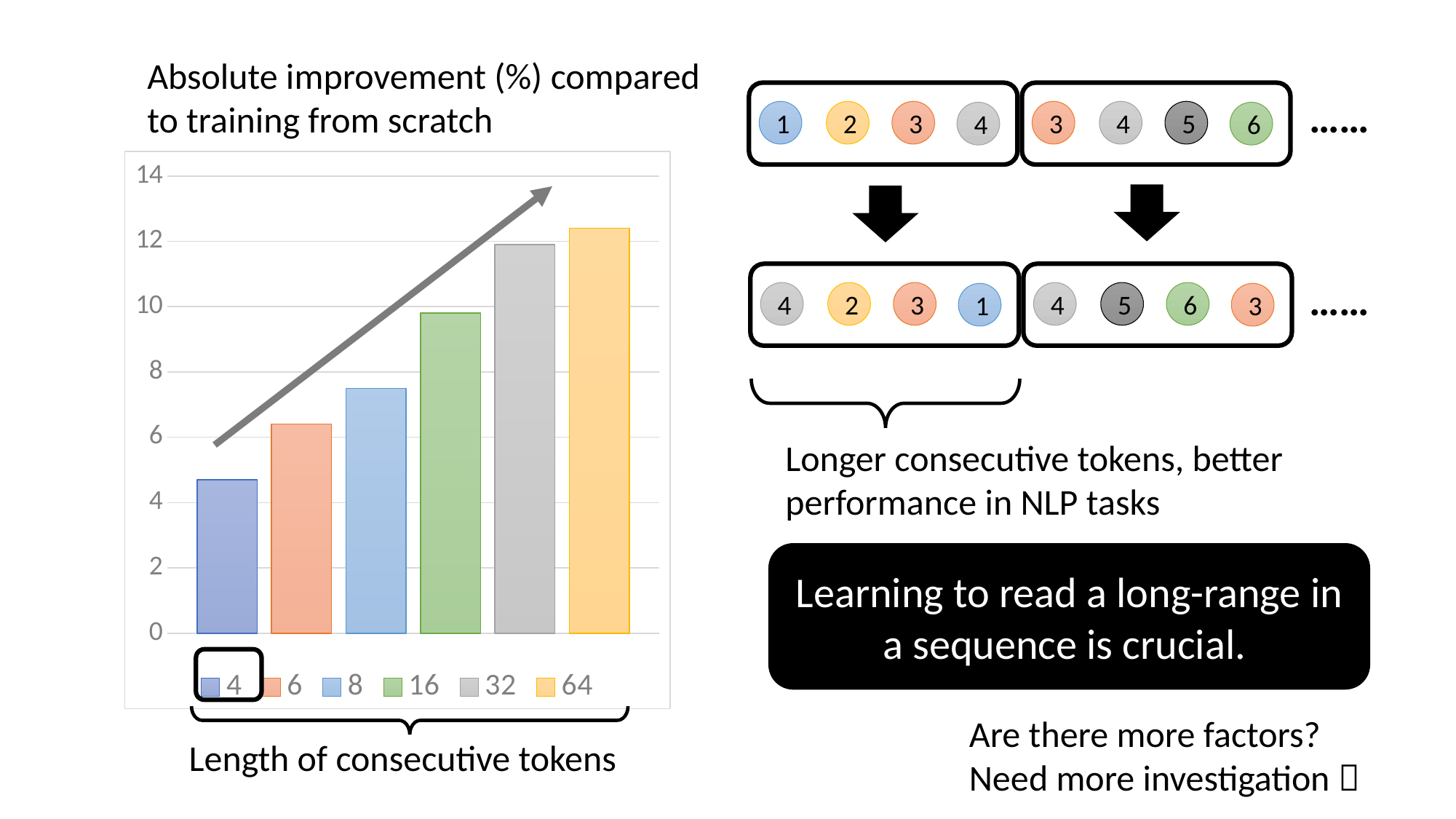
Is the value for length 4 greater or less than 6? less Which length of consecutive tokens has the lowest absolute improvement? 4 How many entries does the chart's legend list? 6 How many bars are plotted in the chart? 6 What kind of chart is shown on the slide? bar chart Which has the larger absolute improvement, length 8 or length 16? 16 Do the bar values rise or fall as the length of consecutive tokens increases from 4 to 64? rise Which length of consecutive tokens has the highest absolute improvement? 64 What label is given below the chart for the x-axis categories? Length of consecutive tokens Is the value for length 32 greater or less than 10? greater Is the value for length 16 greater or less than 8? greater What is the title of the chart? Absolute improvement (%) compared to training from scratch